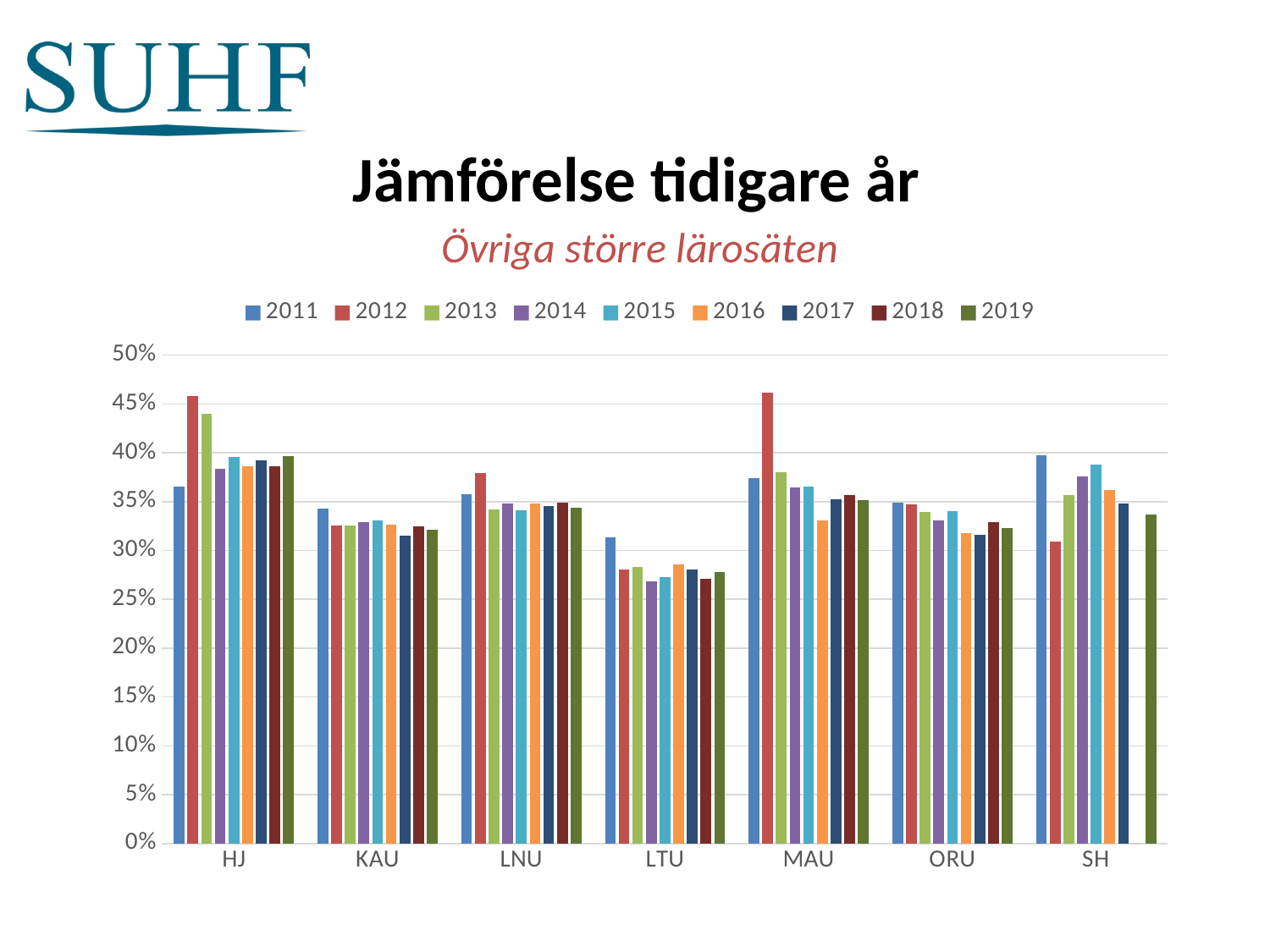
Which is larger for SH: the 2011 value or the 2012 value? 2011 What kind of chart is shown on the slide? Bar chart What is the title of the chart? Jämförelse tidigare år Is the value for HJ in 2012 greater or less than 40%? greater Is the value for LTU in 2014 greater or less than 30%? less Which year has the highest value for LTU? 2011 Which institution has the lowest value for 2012? LTU Is the value for KAU in 2017 greater or less than 35%? less How many categories (institutions) are shown on the x axis? 7 Which year has the highest value for MAU? 2012 What is the subtitle shown under the chart title? Övriga större lärosäten How many series does the legend list? 9